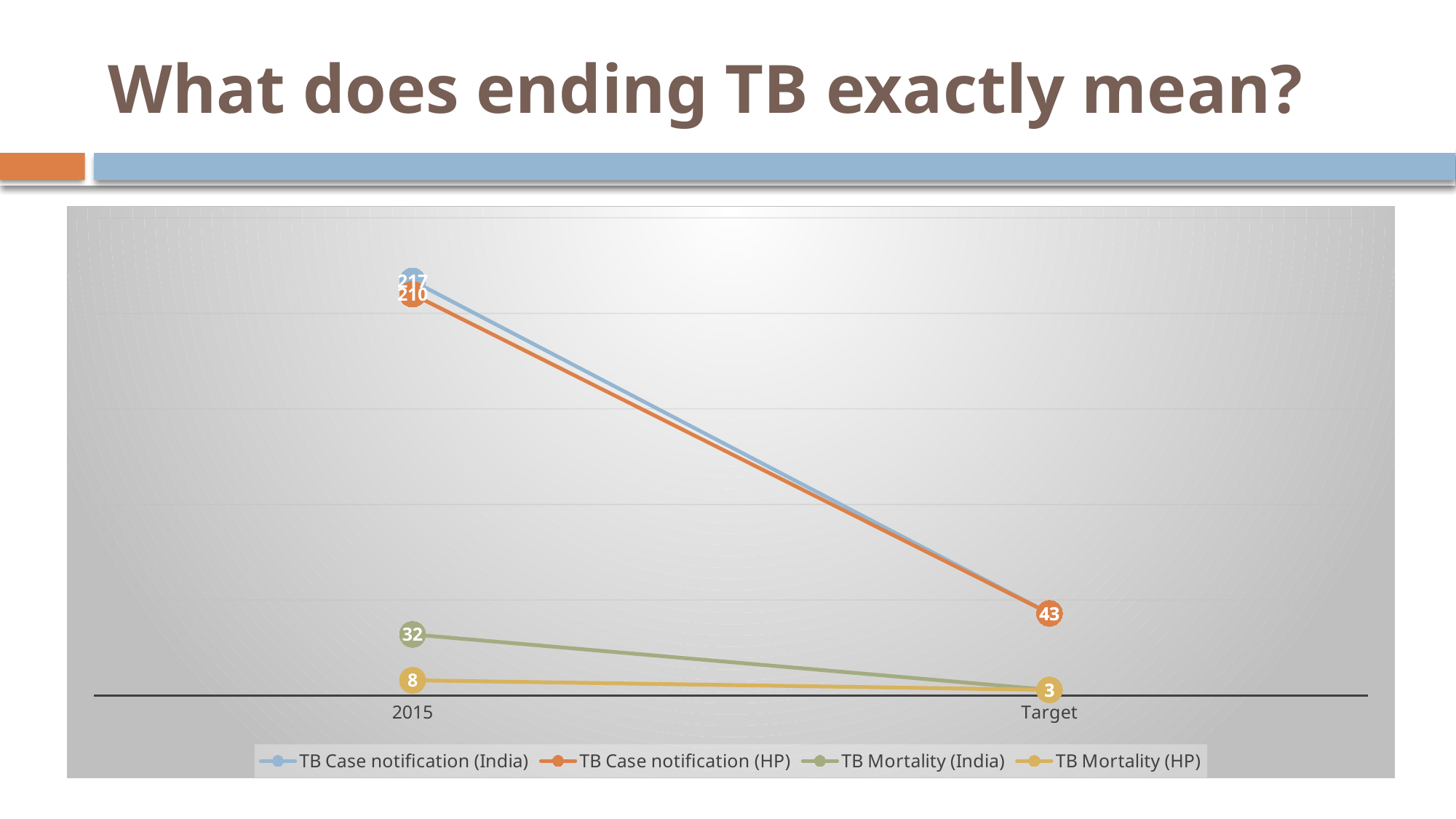
What is the difference between the 2015 value and the Target value for TB Case notification (HP)? 167 How many categories are shown on the x axis? 2 Does the TB Mortality (India) series rise or fall from 2015 to Target? Fall What is the difference between TB Mortality (India) and TB Mortality (HP) in 2015? 24 What is the Target value for TB Mortality (HP)? 3 What is the value for TB Mortality (HP) in 2015? 8 How many series does the legend list? 4 What kind of chart is shown on the slide? Line chart What is the value for TB Mortality (India) in 2015? 32 Which series has the lowest value in 2015? TB Mortality (HP) What is the Target value for TB Case notification (HP)? 43 What is the value for TB Case notification (HP) in 2015? 210